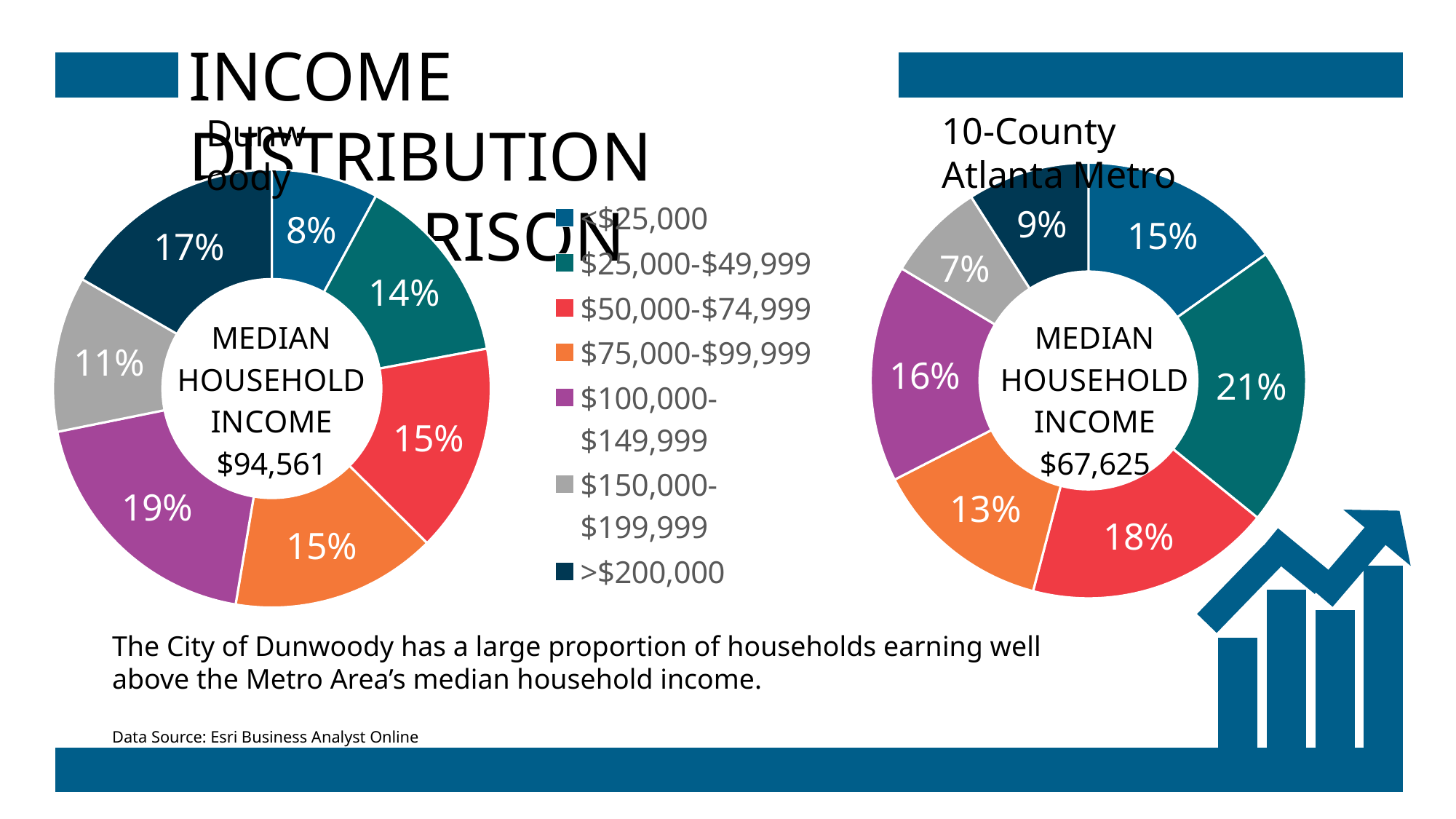
What type of chart is used to show the income distribution on this slide? Donut (pie) chart What is the difference between the >$200,000 share in the Dunwoody chart and the >$200,000 share in the 10-County Atlanta Metro chart? 8 percentage points What median household income is shown in the centre of the right (10-County Atlanta Metro) donut chart? $67,625 In the left (Dunwoody) donut chart, which income bracket has the smallest share? <$25,000 In the left (Dunwoody) donut chart, what share of households earn more than $200,000? 17% In the left (Dunwoody) donut chart, what share of households earn $100,000-$149,999? 19% In the left (Dunwoody) donut chart, which income bracket has the largest share? $100,000-$149,999 In the right (10-County Atlanta Metro) donut chart, what share of households earn $150,000-$199,999? 7% Which chart shows a larger share of households earning less than $25,000, Dunwoody or 10-County Atlanta Metro? 10-County Atlanta Metro In the right (10-County Atlanta Metro) donut chart, what share of households earn $25,000-$49,999? 21% How many income brackets does the legend list? 7 In the right (10-County Atlanta Metro) donut chart, which income bracket has the smallest share? $150,000-$199,999